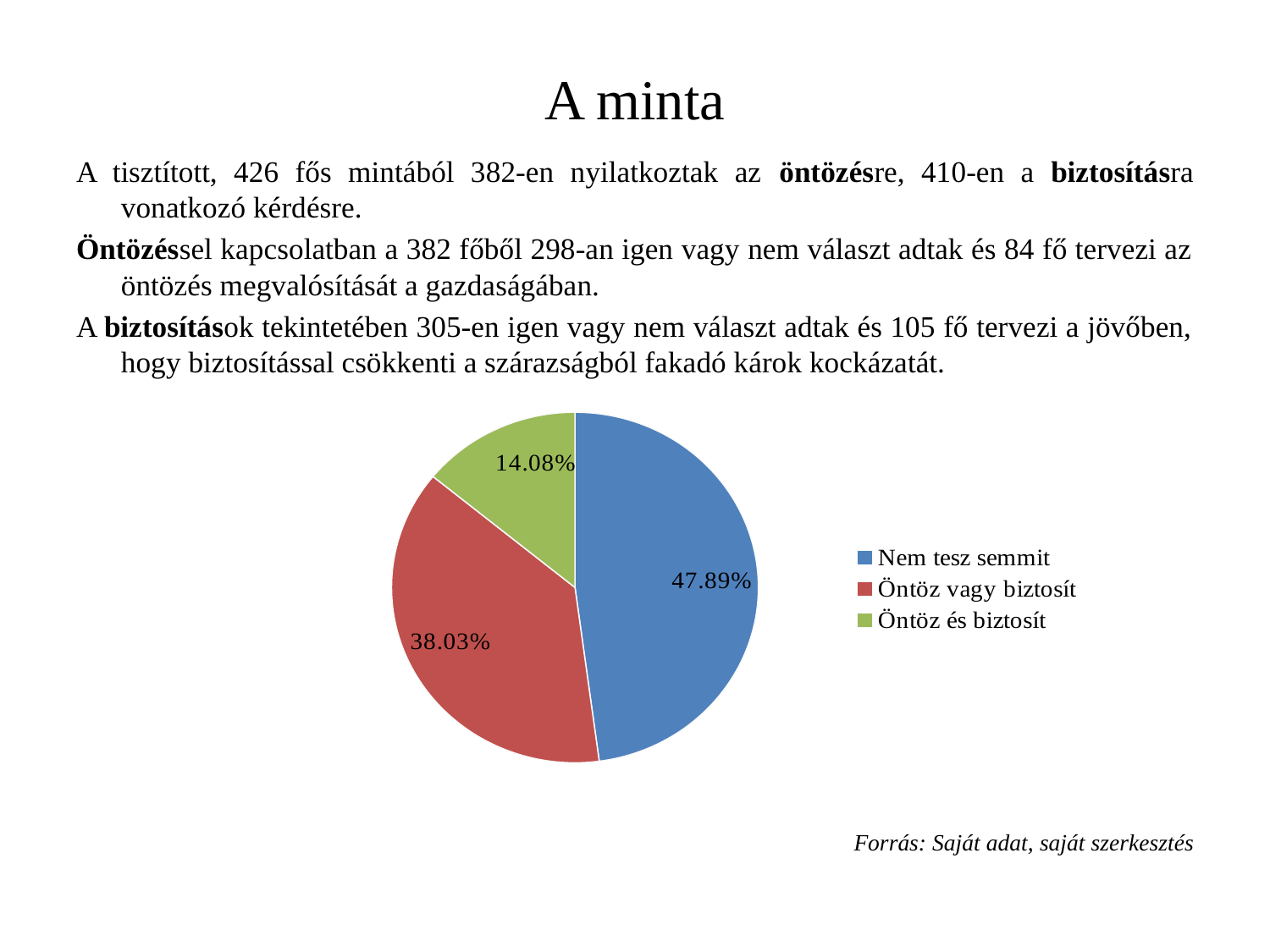
Which is larger, the slice for "Öntöz vagy biztosít" or the slice for "Öntöz és biztosít"? Öntöz vagy biztosít Which legend entry is shown in red? Öntöz vagy biztosít How many slices does the pie chart have? 3 What kind of chart is shown on the slide? pie chart What is the difference in percentage points between "Nem tesz semmit" and "Öntöz vagy biztosít"? 9.86 What share of the pie does "Öntöz és biztosít" represent? 14.08% What colour is the slice for "Öntöz és biztosít"? green What share of the pie does "Nem tesz semmit" represent? 47.89% Which category has the smallest slice of the pie? Öntöz és biztosít What is the difference in percentage points between "Öntöz vagy biztosít" and "Öntöz és biztosít"? 23.95 What share of the pie does "Öntöz vagy biztosít" represent? 38.03% Which category has the largest slice of the pie? Nem tesz semmit